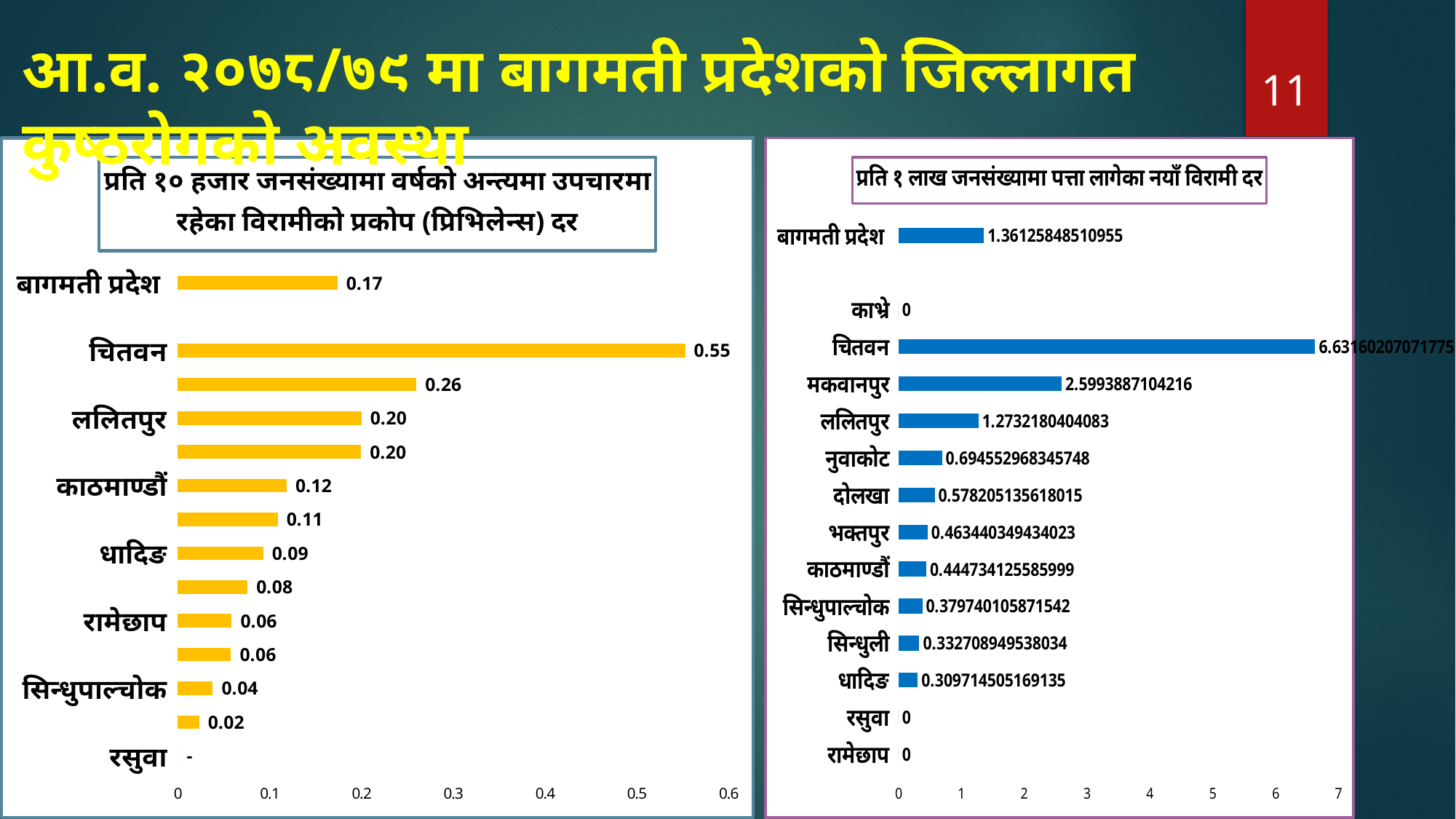
In the right chart, which district has the highest value? चितवन In the right chart, how many categories are plotted? 14 In the right chart (प्रति १ लाख जनसंख्यामा पत्ता लागेका नयाँ विरामी दर), what is the value for मकवानपुर? 2.5993887104216 In the right chart, what is the value for नुवाकोट? 0.694552968345748 In the right chart, is the value for चितवन greater or less than 6? greater In the left chart, what is the difference between the values for चितवन and ललितपुर? 0.35 In the left chart, what is the value for बागमती प्रदेश? 0.17 In the right chart, what is the value for बागमती प्रदेश? 1.36125848510955 What type of chart is the left chart? Bar chart In the left chart, which is larger, the value for काठमाण्डौं or the value for धादिङ? काठमाण्डौं In the right chart, which is larger, the value for दोलखा or the value for भक्तपुर? दोलखा In the left chart (प्रति १० हजार जनसंख्यामा ... प्रिभिलेन्स दर), what is the value for चितवन? 0.55